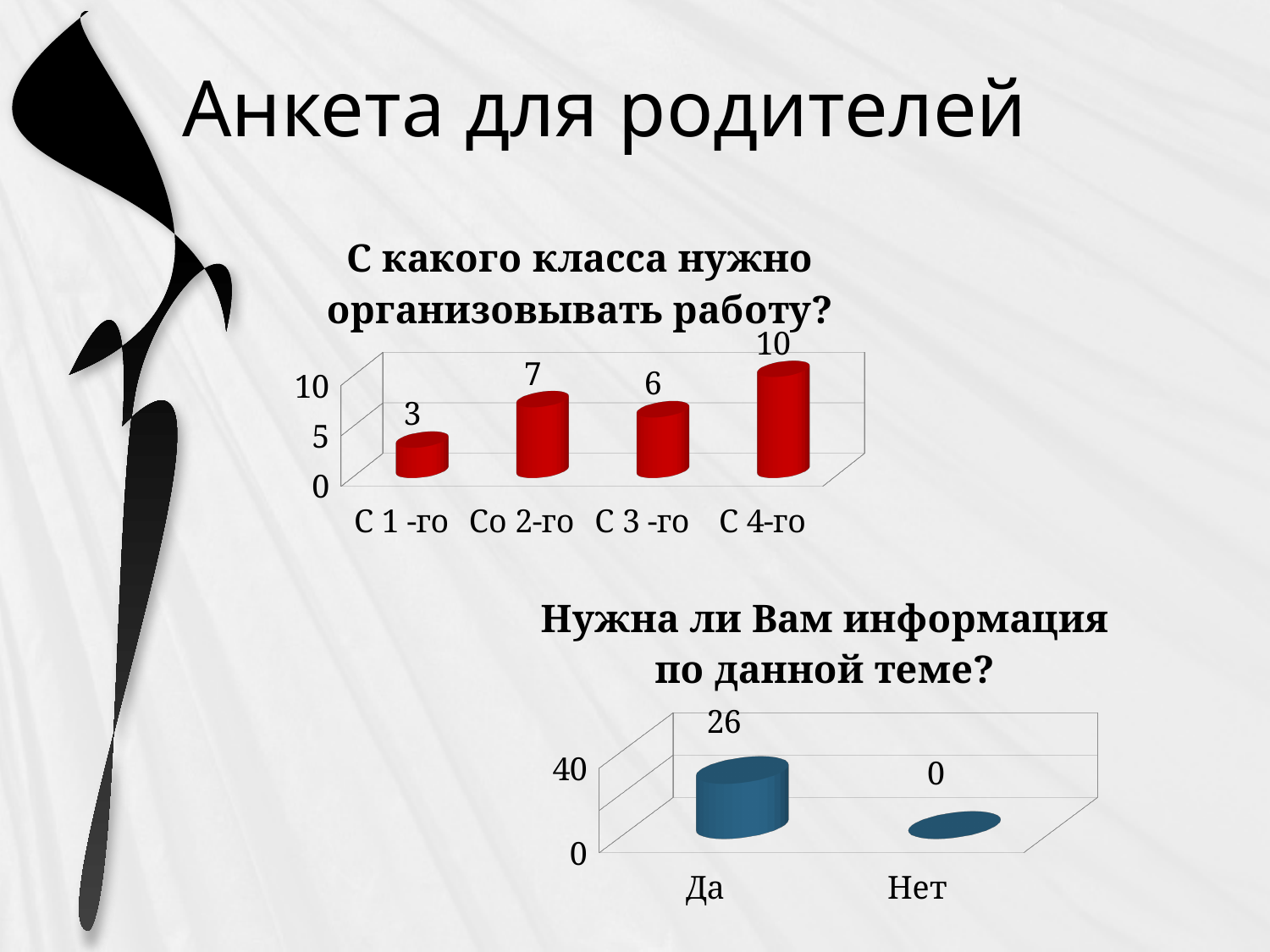
In the chart 'С какого класса нужно организовывать работу?', what is the value for 'Со 2-го'? 7 In the chart 'С какого класса нужно организовывать работу?', which category has the lowest value? С 1 -го In the chart 'С какого класса нужно организовывать работу?', what is the difference between the values for 'С 4-го' and 'С 1 -го'? 7 What colour are the bars in the chart 'С какого класса нужно организовывать работу?'? Red In the chart 'Нужна ли Вам информация по данной теме?', what is the value for 'Нет'? 0 What kind of chart is 'Нужна ли Вам информация по данной теме?'? Bar chart In the chart 'С какого класса нужно организовывать работу?', which is larger: the value for 'Со 2-го' or 'С 3 -го'? Со 2-го In the chart 'С какого класса нужно организовывать работу?', what is the value for 'С 4-го'? 10 In the chart 'С какого класса нужно организовывать работу?', what is the value for 'С 1 -го'? 3 In the chart 'Нужна ли Вам информация по данной теме?', what is the value for 'Да'? 26 In the chart 'С какого класса нужно организовывать работу?', which category has the highest value? С 4-го How many categories are shown in the chart 'С какого класса нужно организовывать работу?'? 4